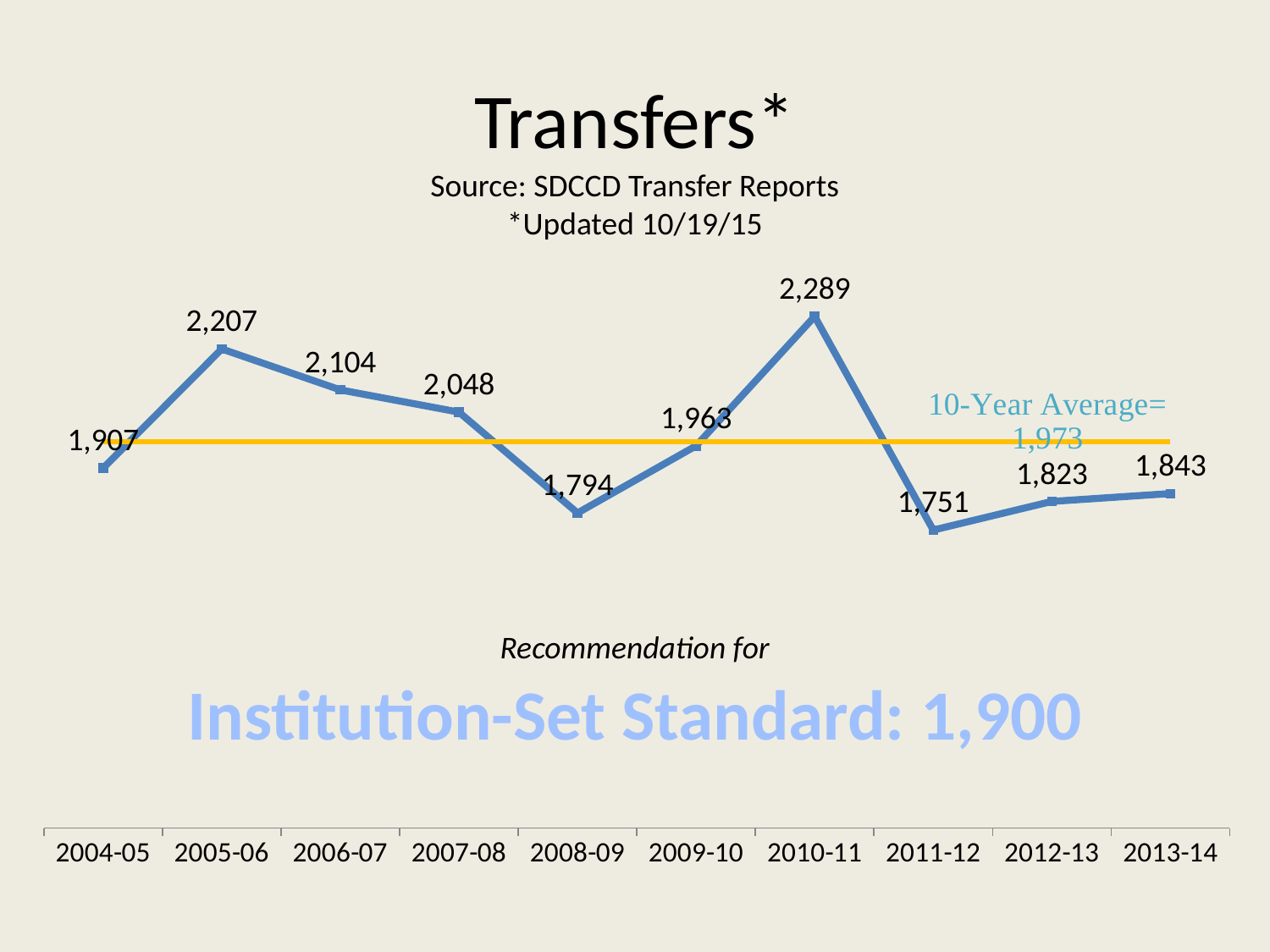
What is the number of transfers for 2010-11? 2,289 How many academic years are plotted on the chart? 10 Which year has the highest number of transfers? 2010-11 Which year has the lowest number of transfers? 2011-12 What is the difference in transfers between 2005-06 and 2006-07? 103 Do transfers rise or fall from 2005-06 to 2008-09? Fall What is the number of transfers for 2013-14? 1,843 What is the difference in transfers between 2010-11 and 2011-12? 538 What is the number of transfers for 2004-05? 1,907 What kind of chart is shown on the slide? Line chart What value does the horizontal 10-Year Average line represent? 1,973 Which year had more transfers, 2008-09 or 2009-10? 2009-10